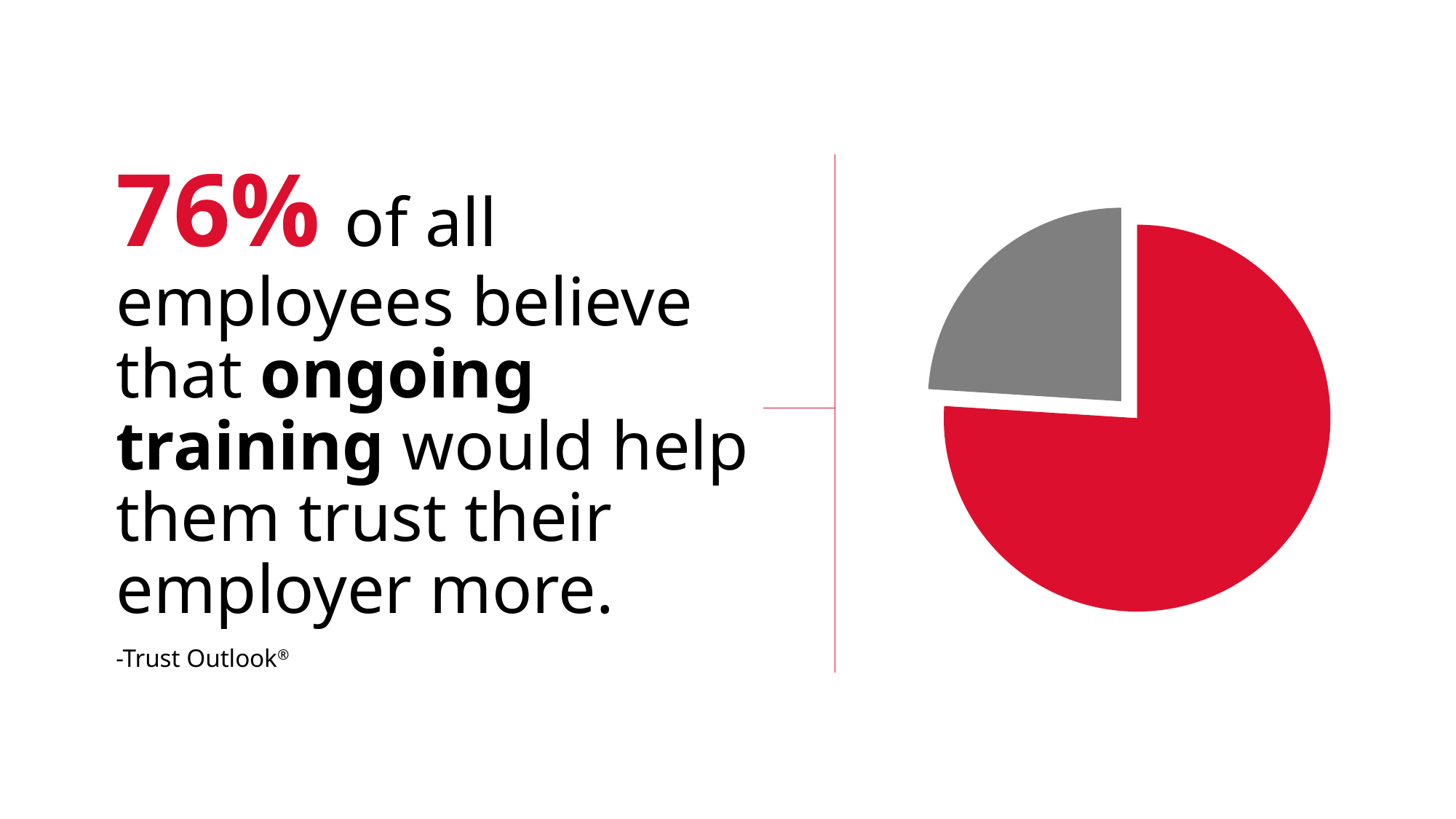
What colour is the largest slice of the pie chart? red What kind of chart is shown on the slide? pie chart What source is cited for the statistic shown in the pie chart? Trust Outlook Is the grey slice of the pie chart greater or less than 50% of the pie? less What share of the pie does the grey slice represent? 24% Is the red slice of the pie chart greater or less than 50% of the pie? greater What share of the pie does the red slice represent, according to the text on the slide? 76% Which slice of the pie chart is larger, the red one or the grey one? red How many slices does the pie chart have? 2